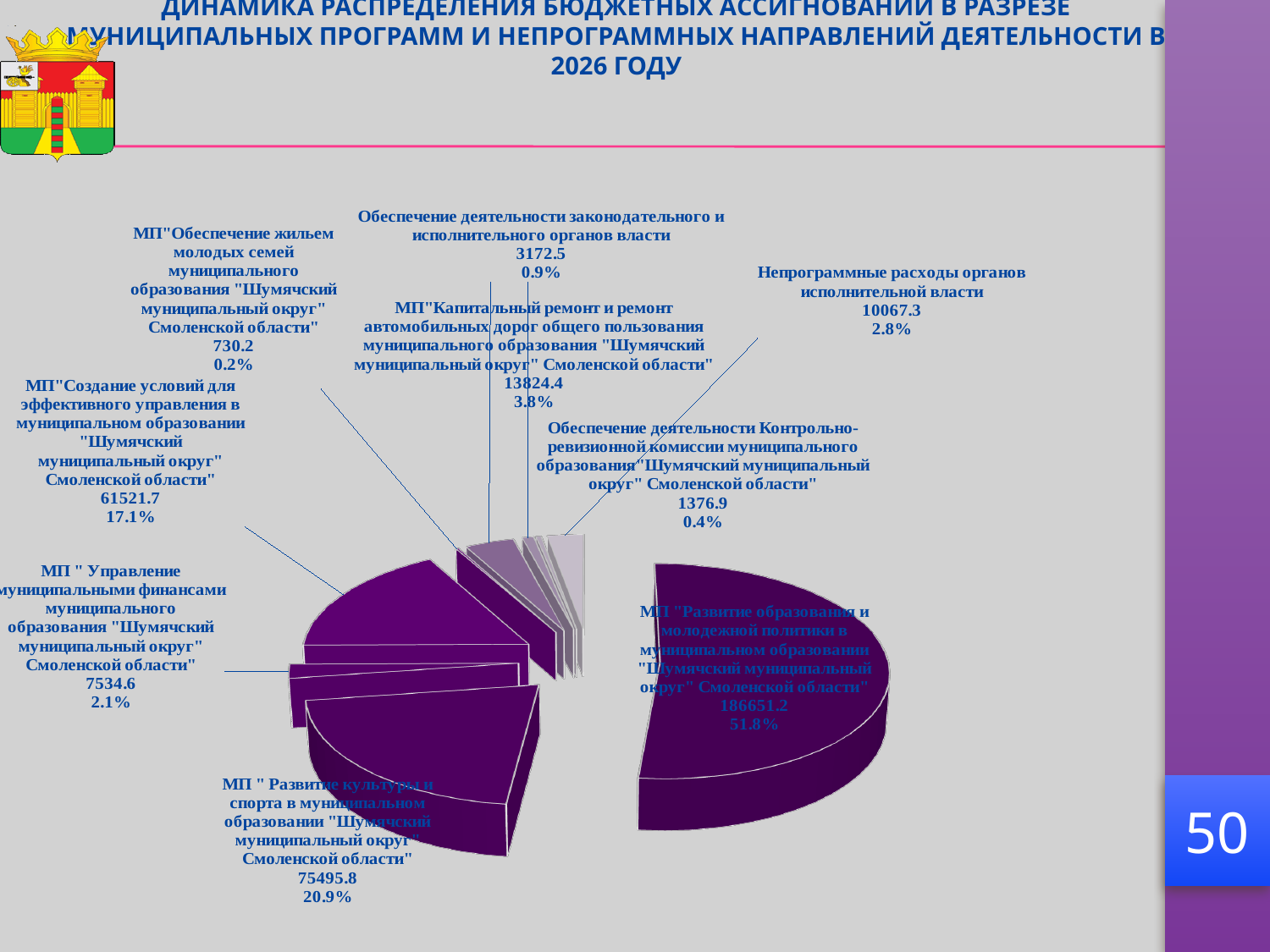
Which is larger: the value for МП "Капитальный ремонт и ремонт автомобильных дорог" or for Непрограммные расходы органов исполнительной власти? МП "Капитальный ремонт и ремонт автомобильных дорог" How many slices does the pie chart have? 9 What is the value shown for Обеспечение деятельности Контрольно-ревизионной комиссии? 1376.9 Which category has the smallest slice of the pie? МП "Обеспечение жильем молодых семей" What kind of chart is shown on the slide? pie chart What percentage is shown for МП "Создание условий для эффективного управления"? 17.1% What share of the pie does МП "Развитие культуры и спорта" represent? 20.9% What is the value shown for Непрограммные расходы органов исполнительной власти? 10067.3 What year does the chart title refer to? 2026 Which category has the largest slice of the pie? МП "Развитие образования и молодежной политики" What is the value shown for МП "Развитие образования и молодежной политики"? 186651.2 What is the difference between the values for МП "Развитие культуры и спорта" (75495.8) and МП "Создание условий для эффективного управления" (61521.7)? 13974.1